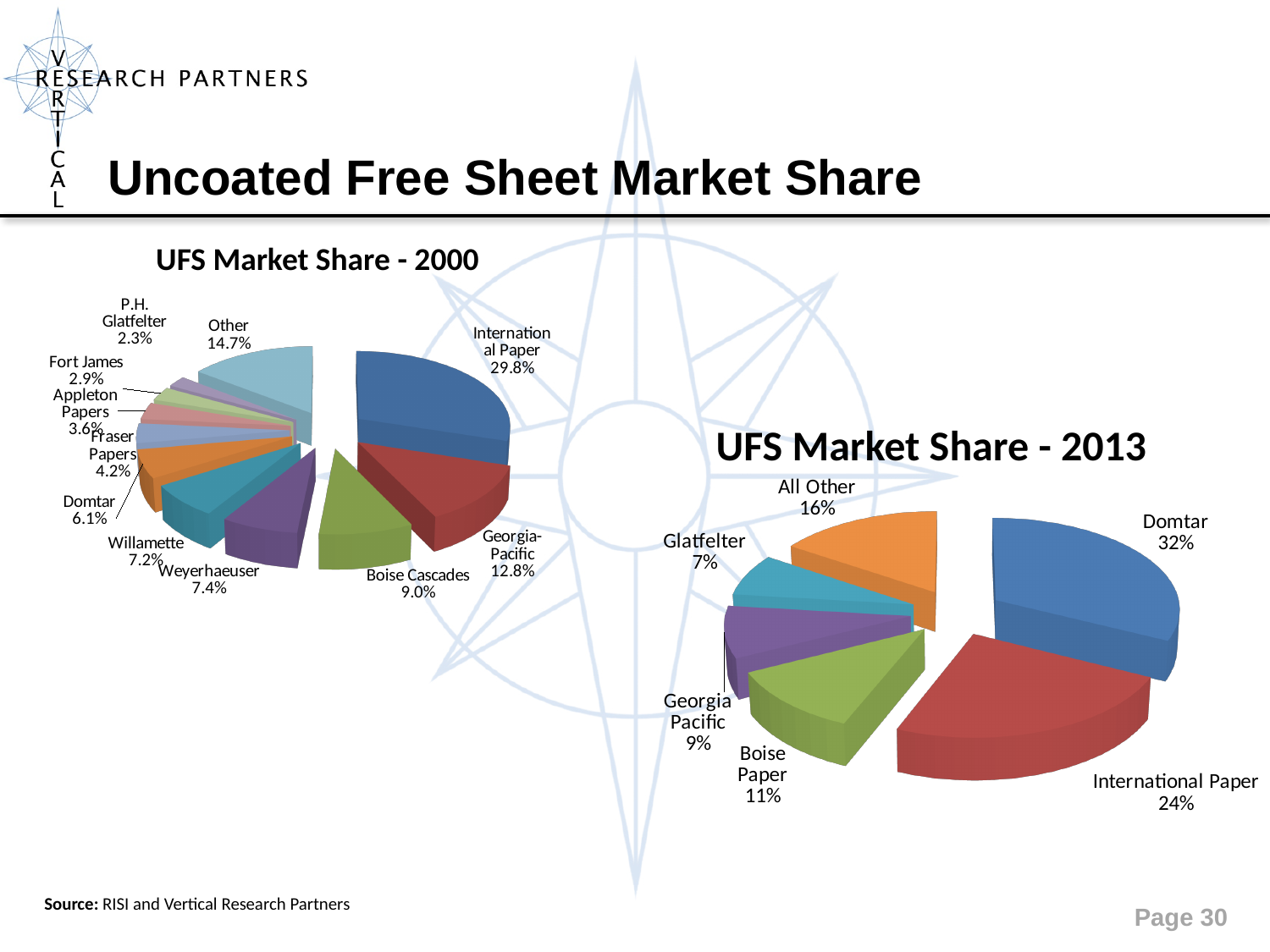
In the UFS Market Share - 2013 chart, what is the difference between Domtar's share and International Paper's share? 8% How many slices does the UFS Market Share - 2013 pie chart have? 6 In the UFS Market Share - 2013 chart, which company has the largest share? Domtar What type of chart is used for UFS Market Share - 2013? Pie chart In the UFS Market Share - 2013 chart, what is the share for Glatfelter? 7% In the UFS Market Share - 2013 chart, what share does Domtar hold? 32% In the UFS Market Share - 2000 chart, what share does International Paper hold? 29.8% In the UFS Market Share - 2000 chart, which company has the smallest share? P.H. Glatfelter In the UFS Market Share - 2000 chart, which is larger, the share for Weyerhaeuser or the share for Domtar? Weyerhaeuser In the UFS Market Share - 2000 chart, which named company has the largest share? International Paper In the UFS Market Share - 2000 chart, what is the share for Boise Cascades? 9.0% How many slices does the UFS Market Share - 2000 pie chart have? 11